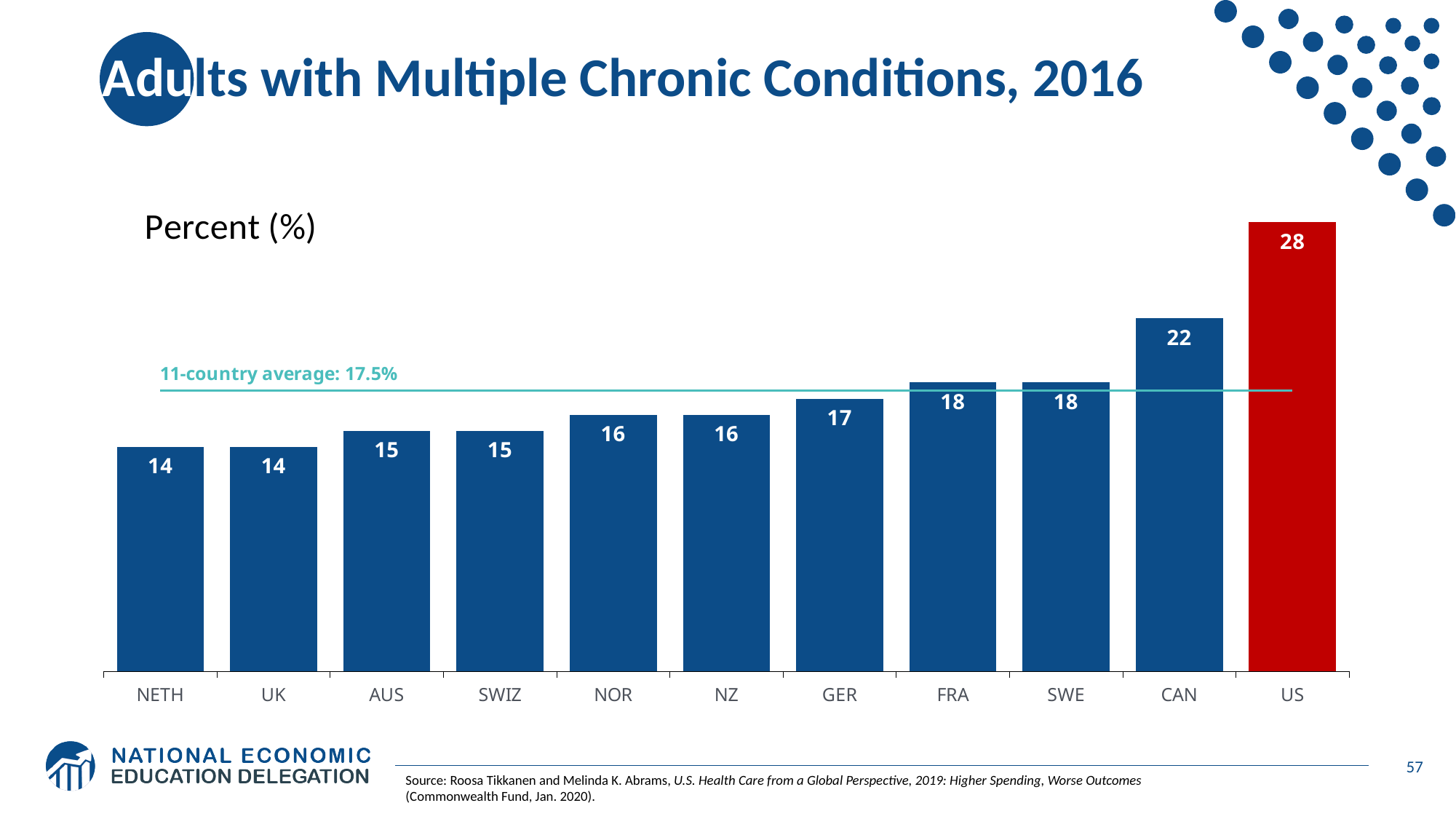
Do the values rise or fall from left to right along the x axis? rise How many countries are shown on the chart? 11 What kind of chart is shown on the slide? bar chart Which country has the highest value? US What is the value for GER? 17 What is the value for the US? 28 Which country's bar is coloured red? US What is the difference between the values for the US and CAN? 6 What is the difference between the values for SWE and NETH? 4 What is the value for CAN? 22 Which has a larger value, NOR or FRA? FRA What is the 11-country average shown on the chart? 17.5%